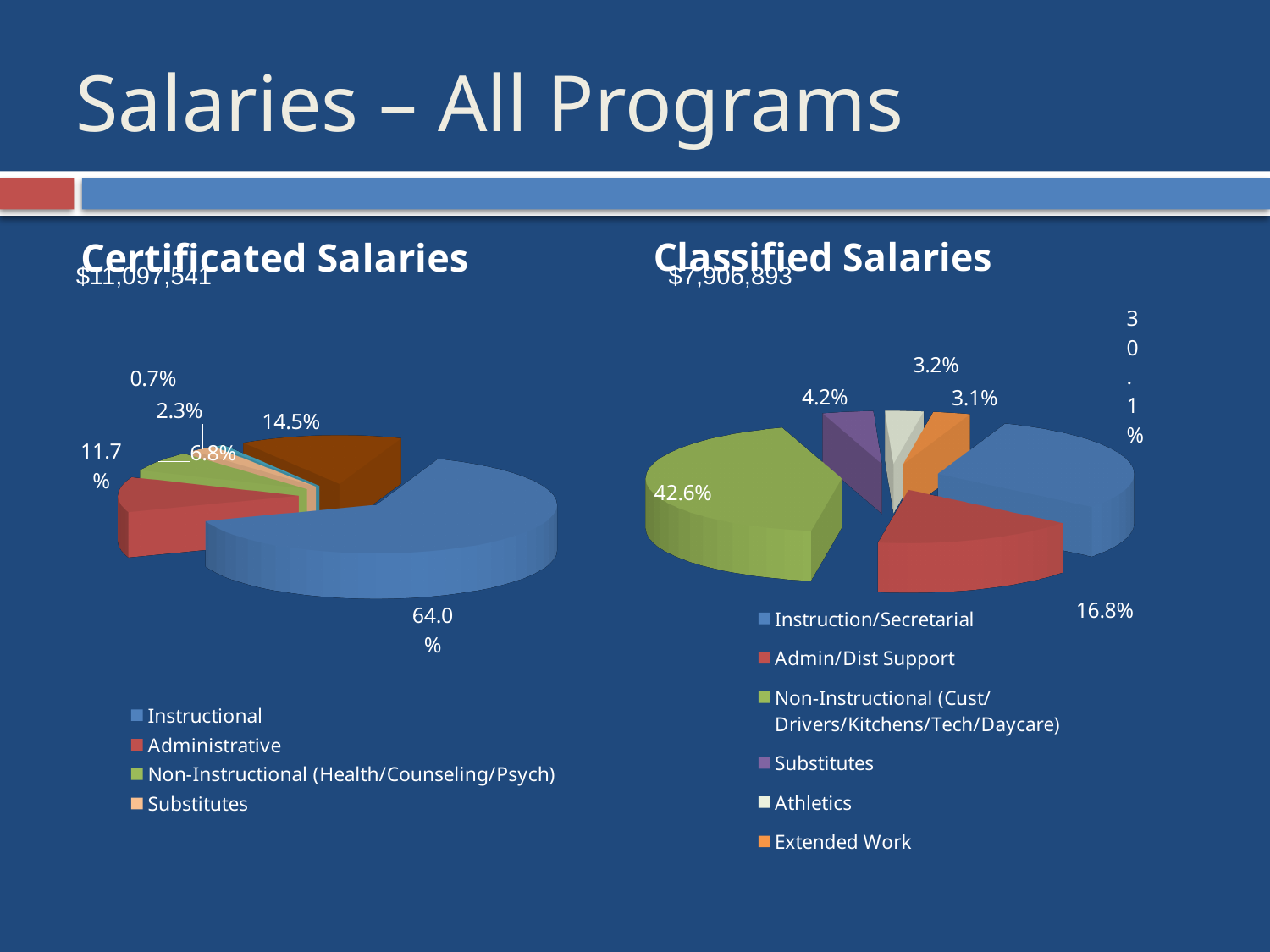
How many entries does the legend of the Classified Salaries chart list? 6 In the Classified Salaries chart, what percentage is shown for Instruction/Secretarial? 30.1% What kind of chart is the Certificated Salaries chart? Pie chart In the Classified Salaries chart, how many percentage points larger is Non-Instructional (Cust/Drivers/Kitchens/Tech/Daycare) than Instruction/Secretarial? 12.5 percentage points In the Classified Salaries chart, what percentage is shown for Non-Instructional (Cust/Drivers/Kitchens/Tech/Daycare)? 42.6% In the Certificated Salaries chart, which category has the largest slice? Instructional In the Certificated Salaries chart, what percentage is shown for Administrative? 11.7% How many entries does the legend of the Certificated Salaries chart list? 4 In the Certificated Salaries chart, what is the smallest percentage labelled on the pie? 0.7% In the Certificated Salaries chart, what share of the pie is Instructional? 64.0% In the Classified Salaries chart, what percentage is shown for Admin/Dist Support? 16.8% In the Certificated Salaries chart, what percentage is shown for Non-Instructional (Health/Counseling/Psych)? 6.8%